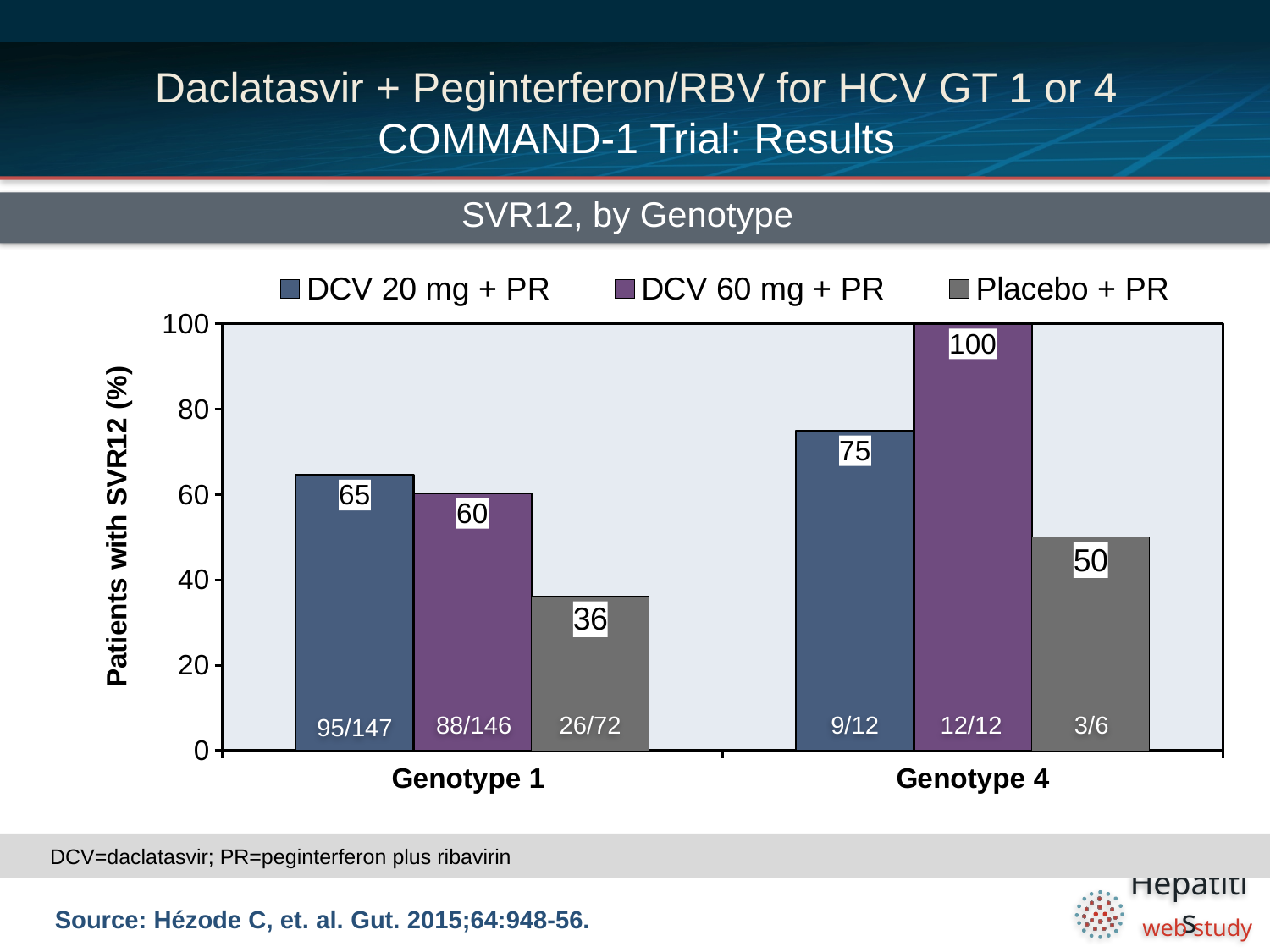
What is the SVR12 rate for Placebo + PR in Genotype 4? 50 Which treatment arm has the lowest SVR12 rate in Genotype 1? Placebo + PR What is the SVR12 rate for DCV 60 mg + PR in Genotype 1? 60 What fraction of patients is shown for the Placebo + PR bar in Genotype 1? 26/72 What is the difference in SVR12 rate between DCV 20 mg + PR and Placebo + PR in Genotype 1? 29 Which is larger: the SVR12 rate for DCV 20 mg + PR in Genotype 1 or in Genotype 4? Genotype 4 How many treatment arms does the legend list? 3 What is the SVR12 rate for DCV 20 mg + PR in Genotype 4? 75 What is the label of the y axis? Patients with SVR12 (%) What kind of chart is shown on the slide? Bar chart How many genotype groups are shown on the x axis? 2 Which treatment arm has the highest SVR12 rate in Genotype 4? DCV 60 mg + PR